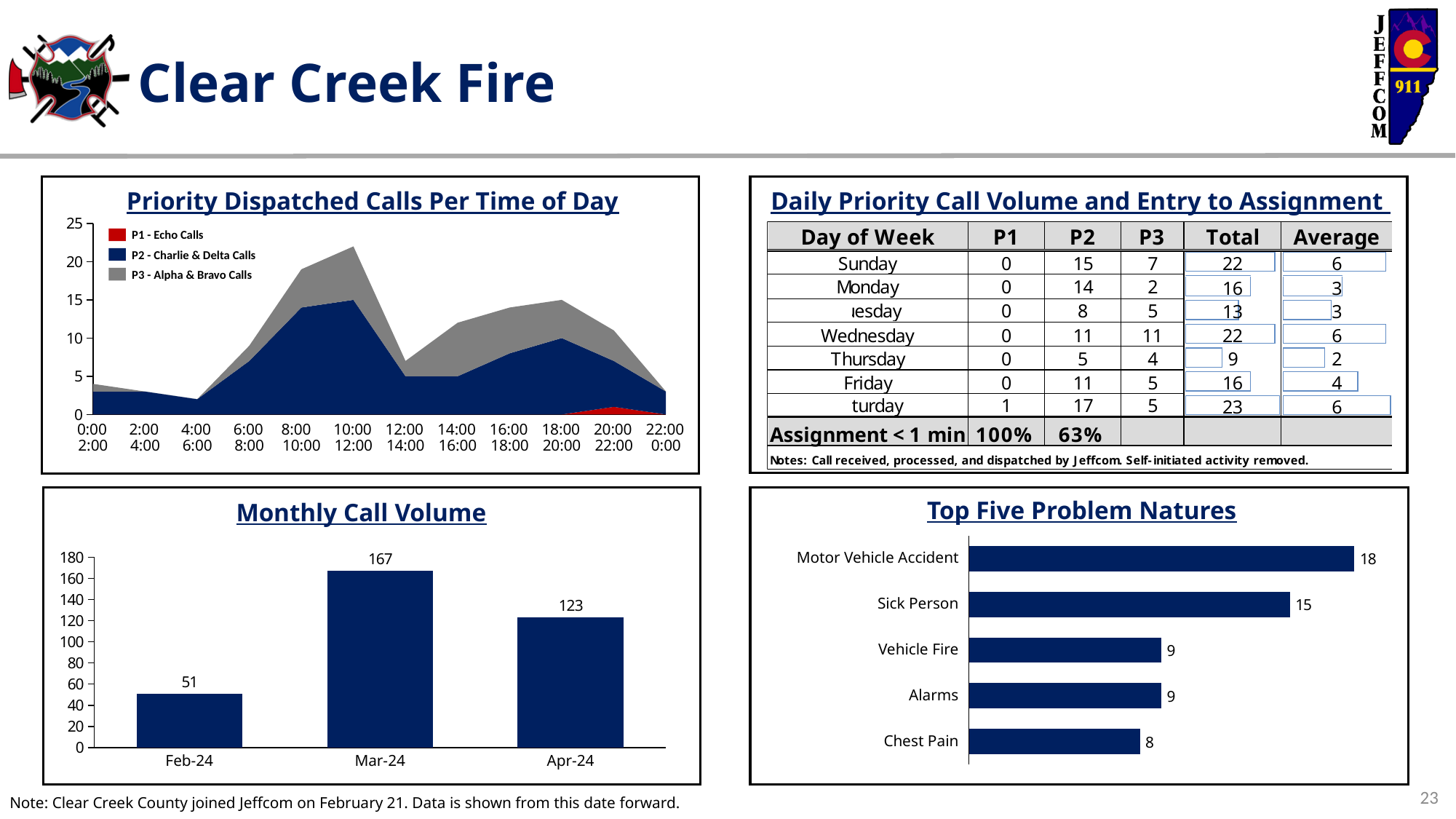
In the Top Five Problem Natures chart, which problem nature has the highest value? Motor Vehicle Accident In the Priority Dispatched Calls Per Time of Day chart, how many series does the legend list? 3 What kind of chart is the Monthly Call Volume chart? Bar chart In the Monthly Call Volume chart, what is the difference between the Mar-24 and Apr-24 values? 44 In the Monthly Call Volume chart, what is the value for Mar-24? 167 In the Monthly Call Volume chart, which month has the lowest call volume? Feb-24 In the Monthly Call Volume chart, how many months are shown? 3 In the Top Five Problem Natures chart, what is the difference between Motor Vehicle Accident and Chest Pain? 10 In the Priority Dispatched Calls Per Time of Day chart, is the total value for the 10:00-12:00 time slot greater or less than 20? greater In the Monthly Call Volume chart, what is the value for Feb-24? 51 In the Top Five Problem Natures chart, which is larger, Vehicle Fire or Chest Pain? Vehicle Fire In the Top Five Problem Natures chart, what is the value for Sick Person? 15